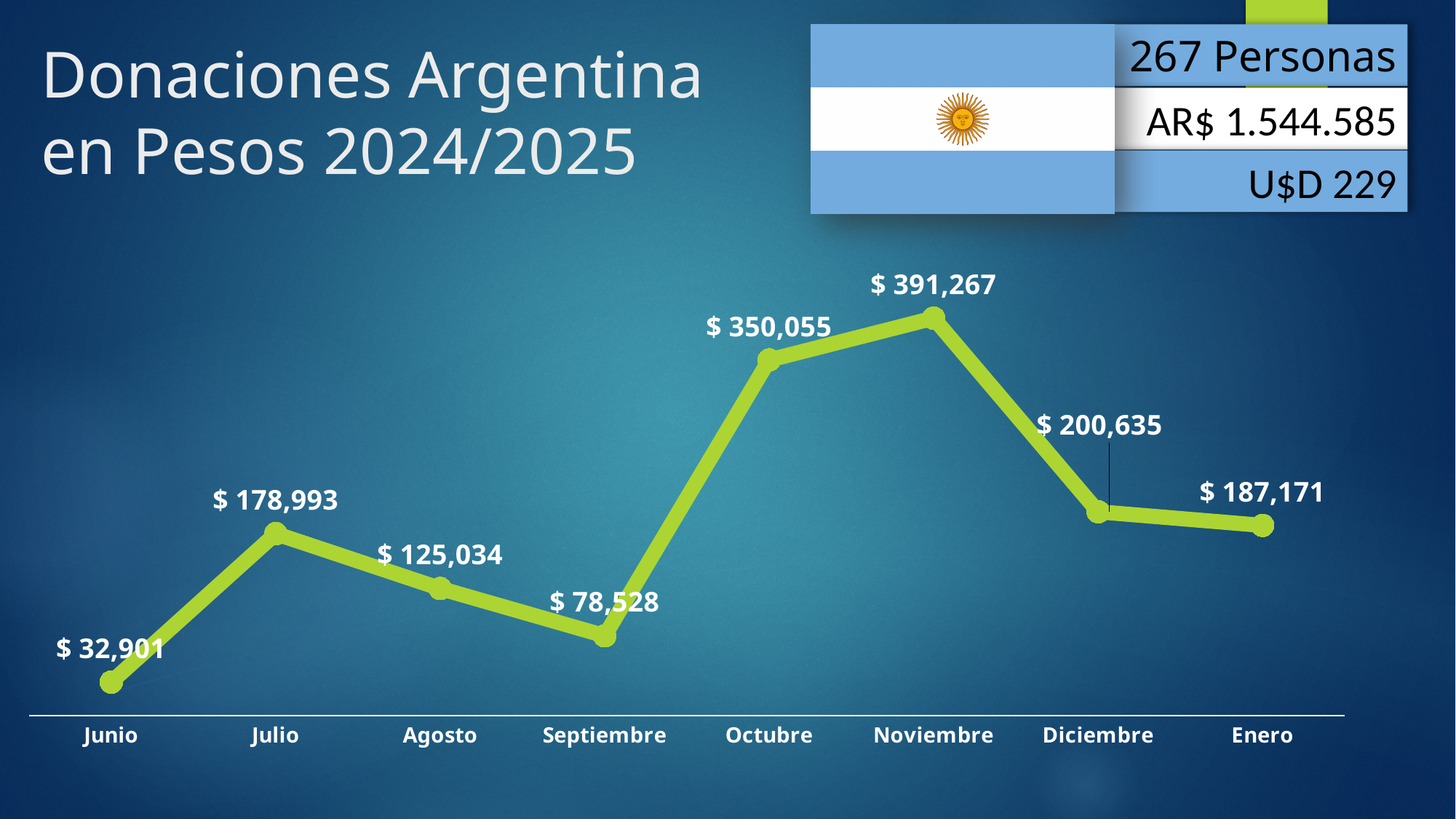
What is the value for Octubre? $ 350,055 What is the difference between the values for Julio and Agosto? $ 53,959 What is the difference between the values for Noviembre and Octubre? $ 41,212 What is the value for Junio? $ 32,901 Which is larger, the value for Diciembre or the value for Enero? Diciembre What kind of chart is shown on the slide? Line chart What is the title of the slide? Donaciones Argentina en Pesos 2024/2025 Do the values rise or fall from Septiembre to Noviembre? Rise Which month has the lowest value? Junio Which month has the highest value? Noviembre What is the value for Diciembre? $ 200,635 How many months are plotted on the chart? 8